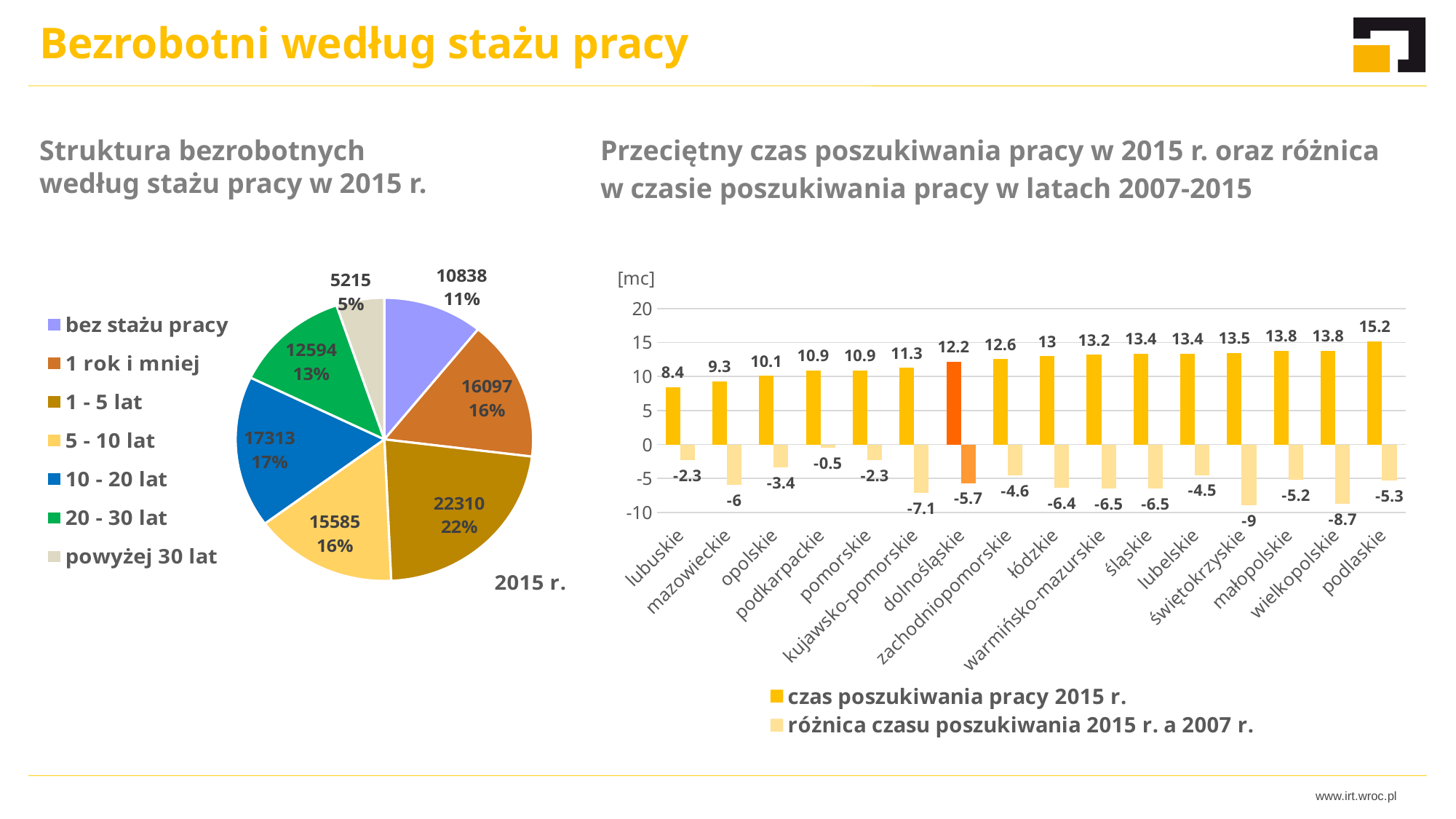
In the pie chart on the left, how many categories does the legend list? 7 In the pie chart on the left, what is the difference between the '10 - 20 lat' value and the '20 - 30 lat' value? 4719 In the bar chart on the right, what is the 'różnica czasu poszukiwania 2015 r. a 2007 r.' value for podkarpackie? -0.5 In the bar chart on the right, what is the value of 'czas poszukiwania pracy 2015 r.' for dolnośląskie? 12.2 In the bar chart on the right, how many series does the legend list? 2 What kind of chart is shown on the right side of the slide? Bar chart In the pie chart on the left, which category has the largest slice? 1 - 5 lat In the bar chart on the right, which voivodeship has the lowest 'różnica czasu poszukiwania 2015 r. a 2007 r.' value? świętokrzyskie In the pie chart on the left, what share does the 'powyżej 30 lat' slice have? 5% In the pie chart on the left, what is the value for the '1 - 5 lat' slice? 22310 In the bar chart on the right, which voivodeship has the highest 'czas poszukiwania pracy 2015 r.' value? podlaskie In the bar chart on the right, is the 'czas poszukiwania pracy 2015 r.' value for lubuskie greater or less than 10? less